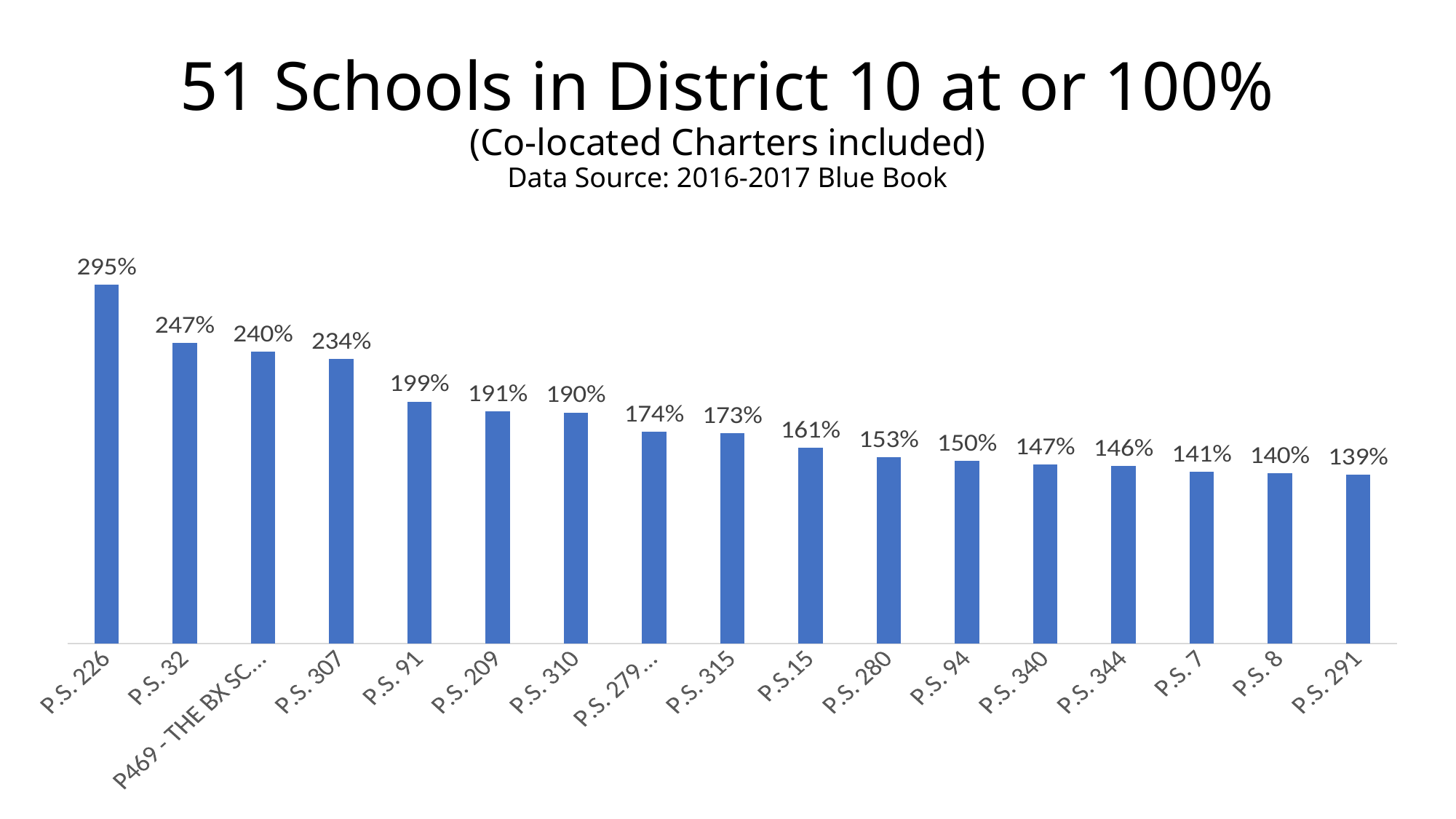
How many schools are shown in the chart? 17 Which school has the lowest value? P.S. 291 What is the difference between the values for P.S. 226 and P.S. 32? 48% What is the value for P.S. 226? 295% Which has a larger value, P.S. 209 or P.S. 280? P.S. 209 Which school has the highest value? P.S. 226 What is the value for P.S. 315? 173% Do the values rise or fall from left to right along the x axis? Fall What is the value for P.S. 291? 139% What is the difference between the values for P.S. 91 and P.S. 310? 9% What is the value for P.S. 307? 234% What kind of chart is shown on the slide? Bar chart